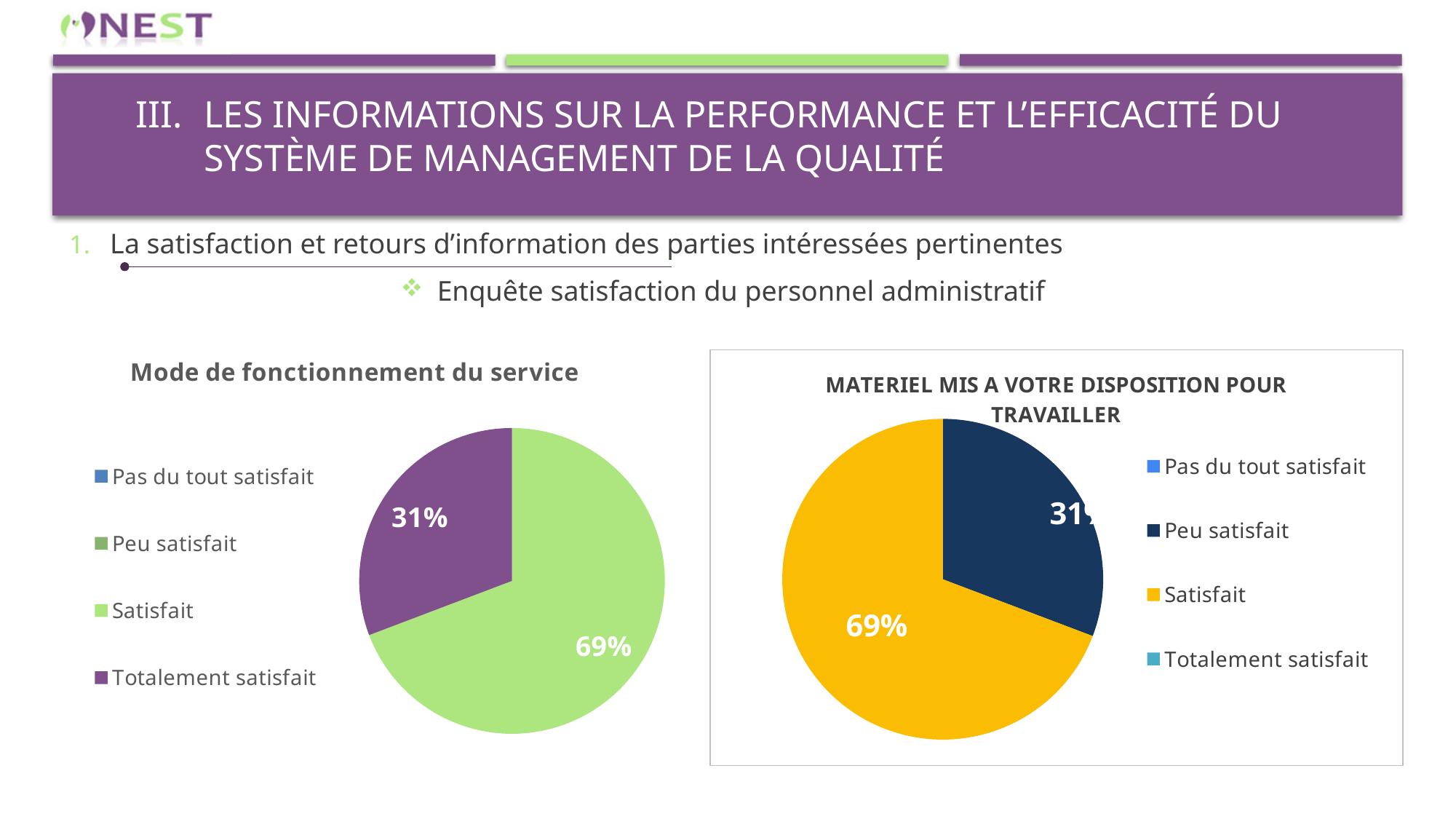
In the "Mode de fonctionnement du service" chart, what share is labelled for Totalement satisfait? 31% In the "MATERIEL MIS A VOTRE DISPOSITION POUR TRAVAILLER" chart, what colour is the Peu satisfait slice? dark blue In the "Mode de fonctionnement du service" chart, which category has the largest slice? Satisfait In the "Mode de fonctionnement du service" chart, what colour is the Satisfait slice? green What kind of chart is "Mode de fonctionnement du service"? pie chart In the "MATERIEL MIS A VOTRE DISPOSITION POUR TRAVAILLER" chart, what share is labelled for Satisfait? 69% In the "MATERIEL MIS A VOTRE DISPOSITION POUR TRAVAILLER" chart, what share is labelled for Peu satisfait? 31% In the "Mode de fonctionnement du service" chart, what is the difference between the Satisfait and Totalement satisfait shares? 38% In the "Mode de fonctionnement du service" chart, what share is labelled for Satisfait? 69% How many entries does the legend of the "MATERIEL MIS A VOTRE DISPOSITION POUR TRAVAILLER" chart list? 4 How many entries does the legend of the "Mode de fonctionnement du service" chart list? 4 In the "MATERIEL MIS A VOTRE DISPOSITION POUR TRAVAILLER" chart, which is larger, Satisfait or Peu satisfait? Satisfait